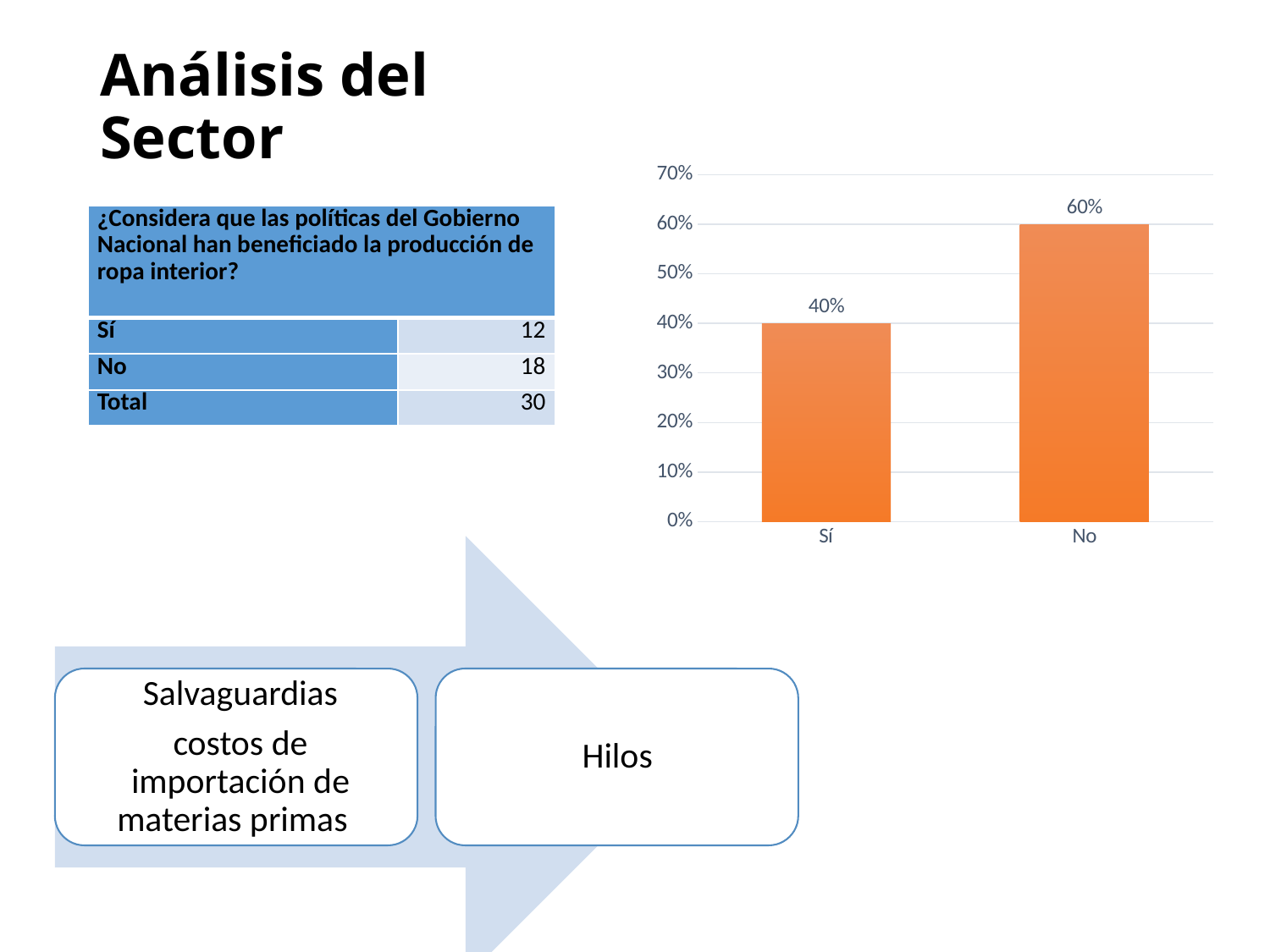
What is the difference between the values for No and Sí in the bar chart? 20% What is the value for No in the bar chart? 60% Which category has the lowest value in the bar chart? Sí Which category has the highest value in the bar chart? No What kind of chart is shown on the slide? Bar chart Which is larger in the bar chart, the value for Sí or the value for No? No What is the highest value shown on the vertical axis of the bar chart? 70% What is the value for Sí in the bar chart? 40% What colour are the bars in the chart? Orange How many categories are shown in the bar chart? 2 Is the value for Sí in the bar chart greater or less than 50%? less Is the value for No in the bar chart greater or less than 50%? greater